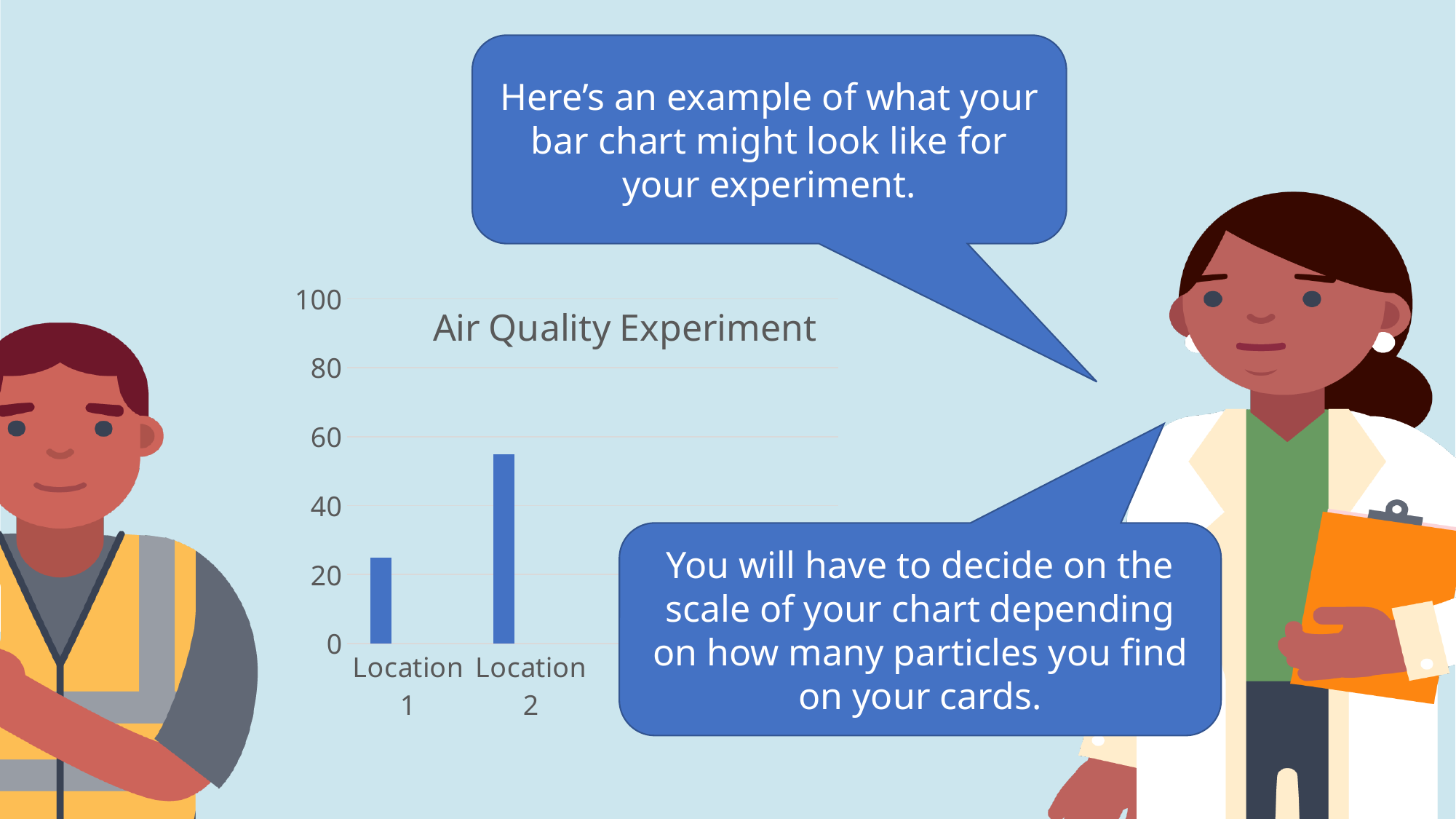
Do the values rise or fall from Location 1 to Location 2? rise What kind of chart is shown on the slide? bar chart What is the highest value shown on the vertical axis of the chart? 100 Is the value for Location 2 greater or less than 60? less Which location has the lowest bar in the chart? Location 1 How many categories are plotted in the chart? 2 Is the value for Location 1 greater or less than 40? less Is the value for Location 2 greater or less than 40? greater What is the title of the chart? Air Quality Experiment Which location has the highest bar in the chart? Location 2 Which is larger, the value for Location 1 or the value for Location 2? Location 2